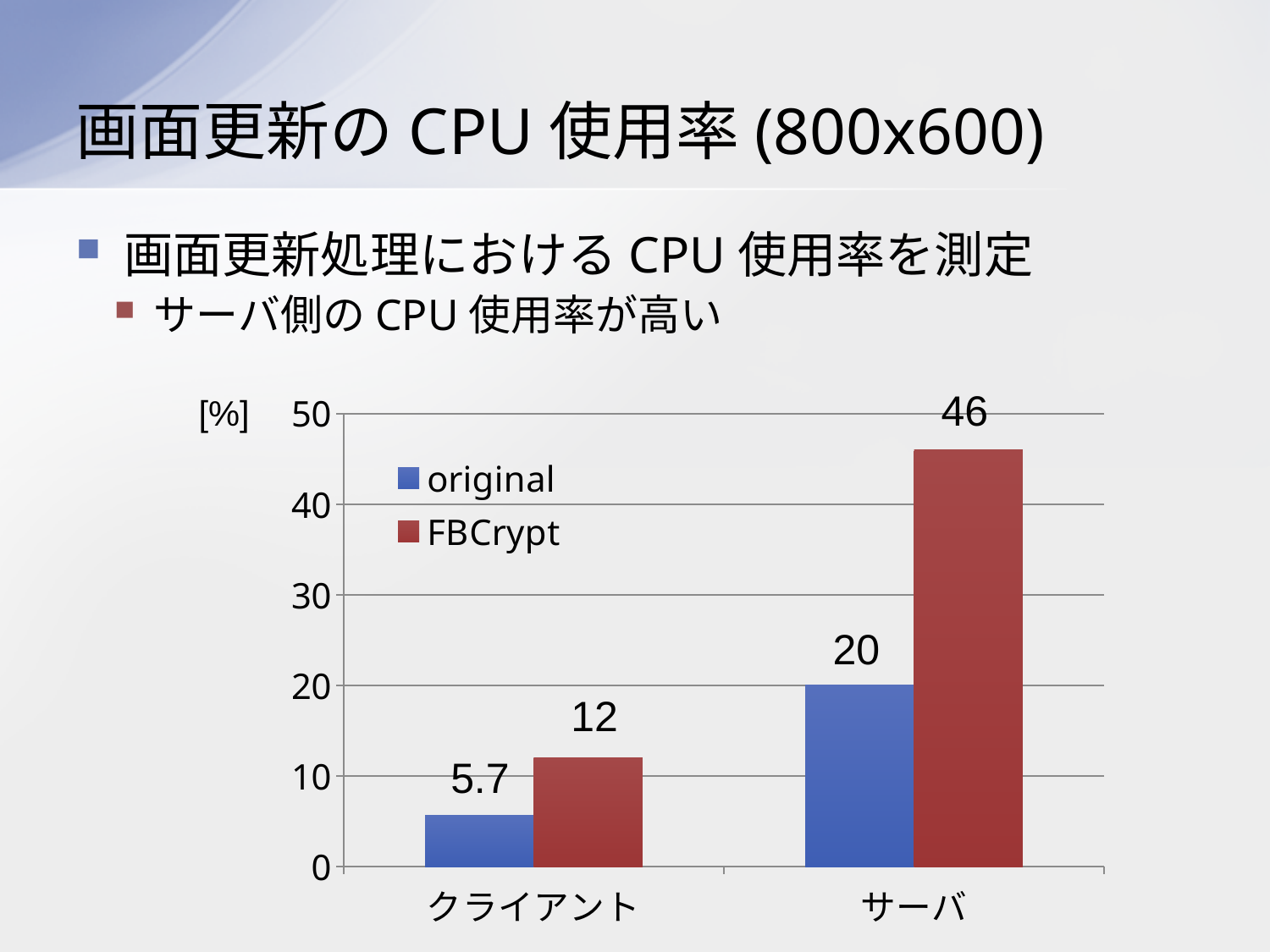
What kind of chart is shown on the slide? bar chart Which category has the highest FBCrypt value? サーバ Which category has the lowest original value? クライアント How many categories are shown on the x axis? 2 What is the CPU usage value for original on クライアント? 5.7 How many series does the legend list? 2 Is the FBCrypt value for サーバ greater or less than 40? greater What is the CPU usage value for FBCrypt on クライアント? 12 What is the difference between the FBCrypt and original values on サーバ? 26 What is the CPU usage value for original on サーバ? 20 Which is larger on クライアント: the original value or the FBCrypt value? FBCrypt What is the CPU usage value for FBCrypt on サーバ? 46